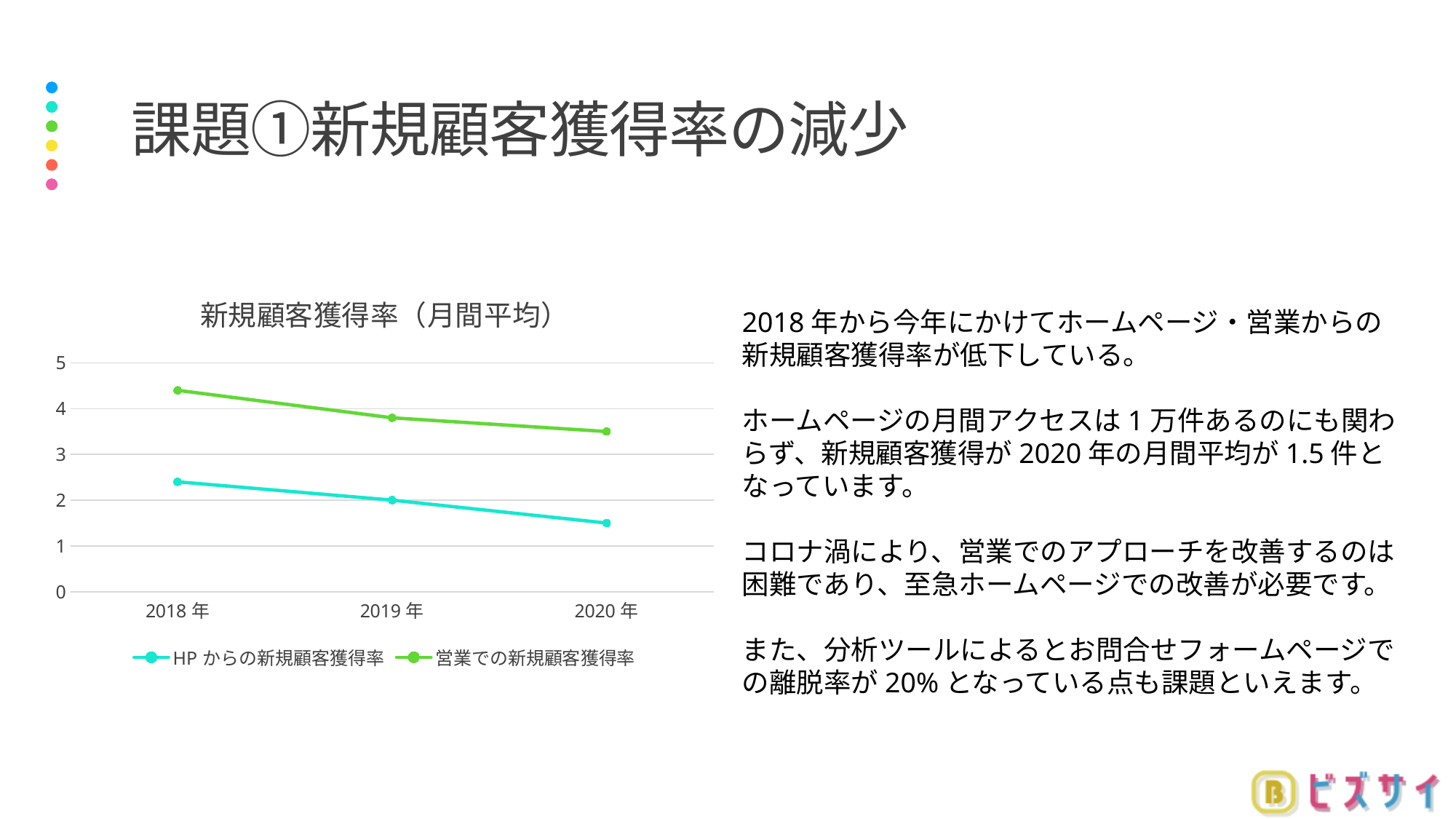
Does the HP からの新規顧客獲得率 series rise or fall from 2018年 to 2020年? Fall Which colour is used for the 営業での新規顧客獲得率 line? Green Is the value for HP からの新規顧客獲得率 in 2018年 greater or less than 2? greater Is the value for HP からの新規顧客獲得率 in 2020年 greater or less than 2? less How many series does the chart legend list? 2 What is the title of the chart? 新規顧客獲得率（月間平均） What kind of chart is shown on the slide? Line chart In 2020年, which series has the higher value, HP からの新規顧客獲得率 or 営業での新規顧客獲得率? 営業での新規顧客獲得率 How many years are plotted along the x axis of the chart? 3